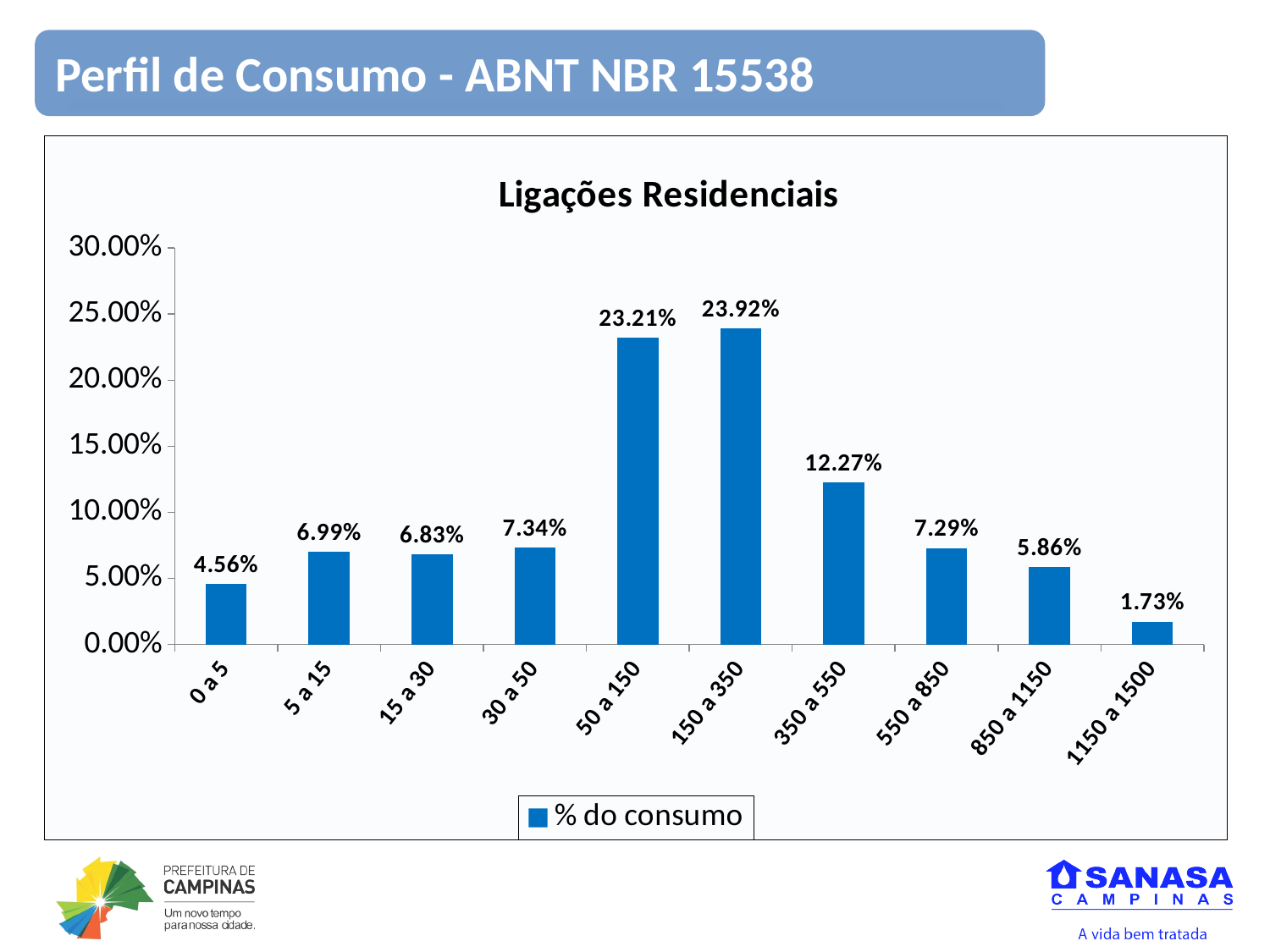
What is the value for the "50 a 150" category? 23.21% What kind of chart is shown? bar chart How many series does the legend list? 1 Is the value for "850 a 1150" greater or less than 10.00%? less How many categories are shown on the x axis? 10 What is the title of the chart? Ligações Residenciais Which category has the lowest value? 1150 a 1500 What is the value for the "0 a 5" category? 4.56% What is the value for the "350 a 550" category? 12.27% What is the difference between the values for "150 a 350" and "50 a 150"? 0.71% Which is larger, the value for "350 a 550" or the value for "550 a 850"? 350 a 550 Which category has the highest value? 150 a 350